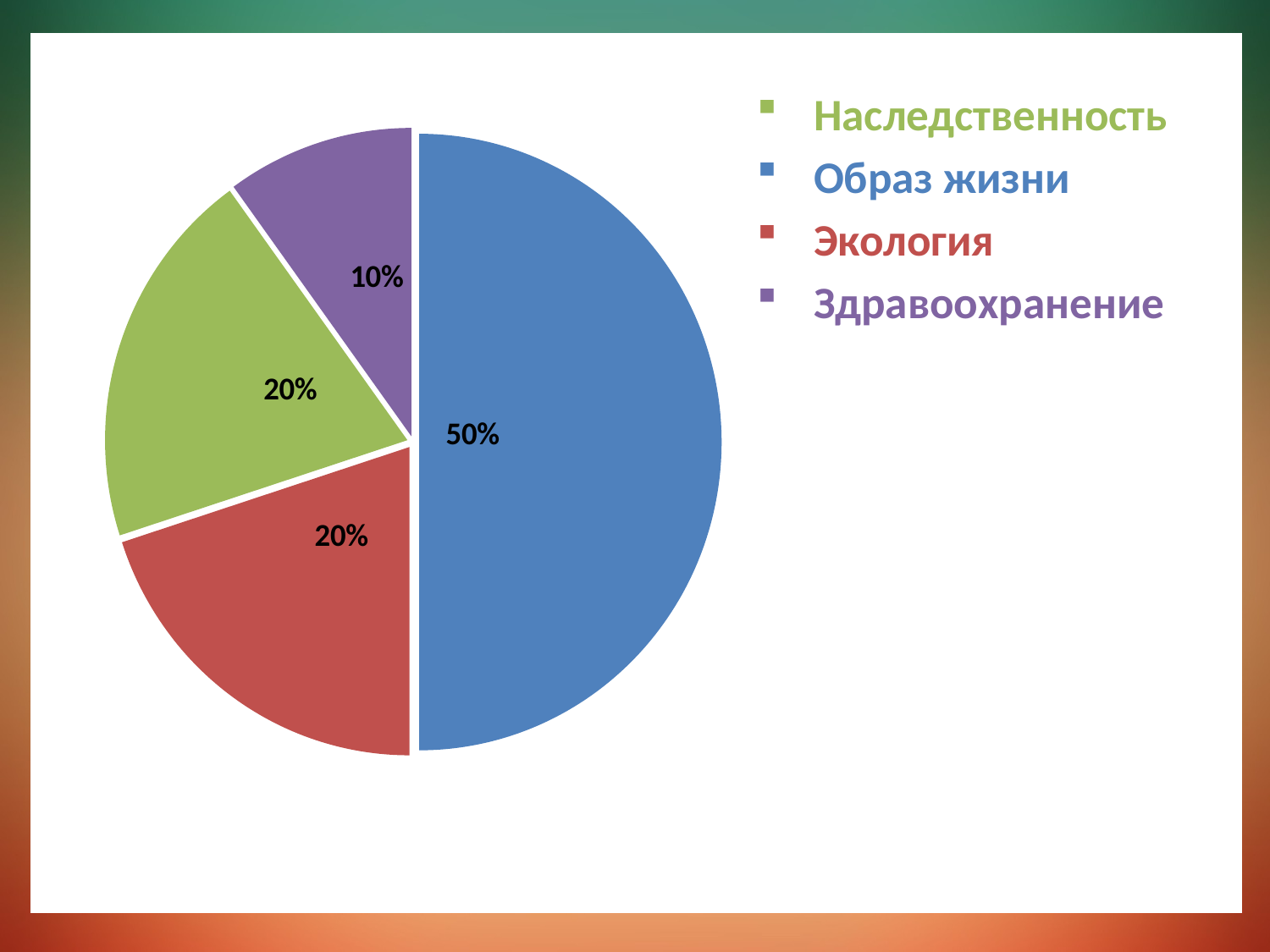
What share of the pie does Экология have? 20% What kind of chart is shown on the slide? pie chart What share of the pie does Образ жизни have? 50% Which category is shown in blue? Образ жизни Which category has the smallest slice of the pie? Здравоохранение What colour is the slice for Наследственность? green What share of the pie does Наследственность have? 20% Which category has the largest slice of the pie? Образ жизни Which is larger, the slice for Образ жизни or the slice for Экология? Образ жизни How many slices does the pie chart have? 4 What is the difference in percentage points between Образ жизни and Здравоохранение? 40